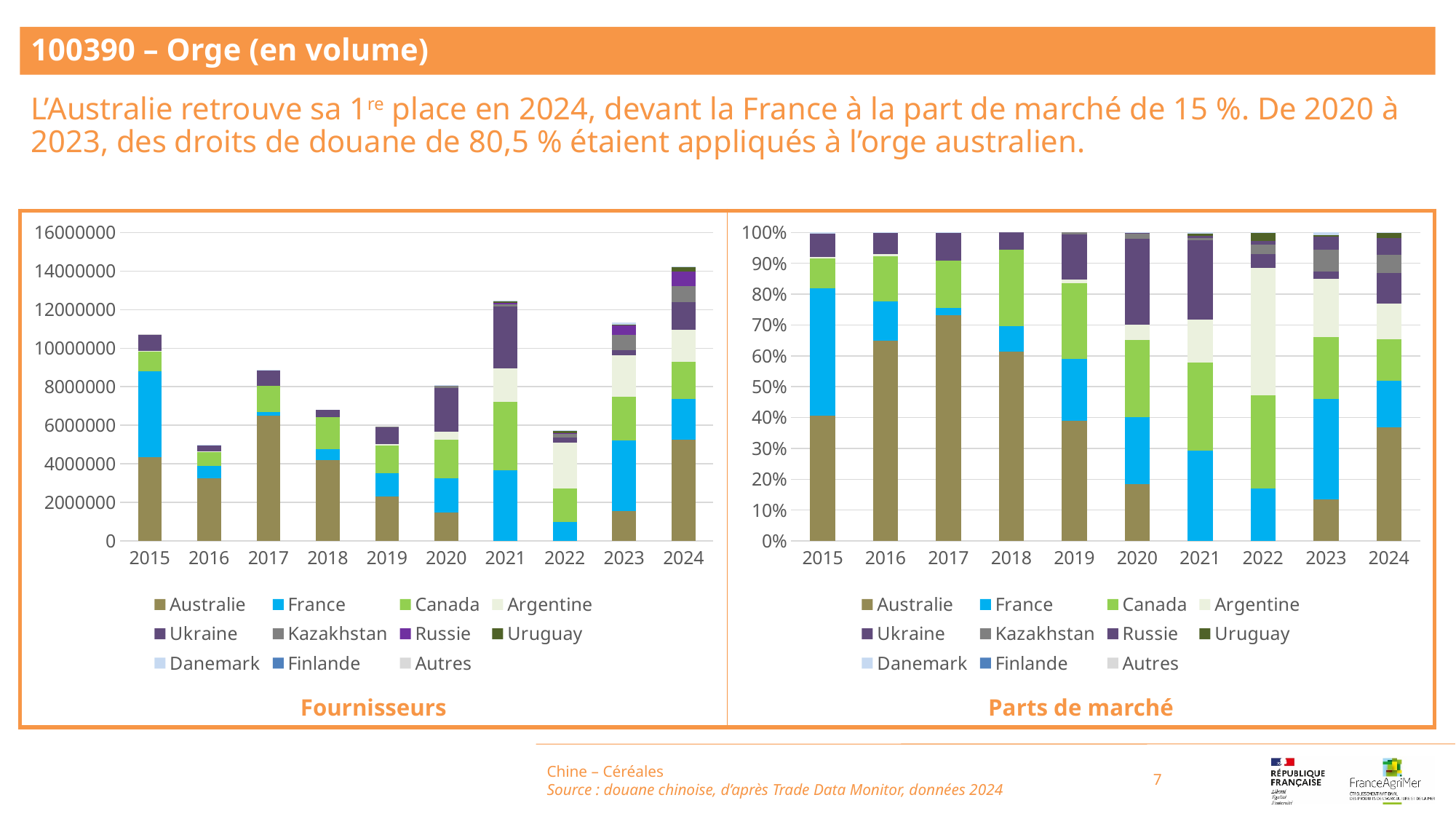
In the 'Parts de marché' chart, is the Australie share in 2015 greater or less than 50%? less How many series does the legend of the 'Fournisseurs' chart list? 11 What is the title printed under the right-hand chart? Parts de marché In the 'Parts de marché' chart, which is larger: the Australie share in 2017 or in 2019? 2017 In the 'Fournisseurs' chart, is the Australie value for 2017 greater or less than 6000000? greater Which series is shown in light blue (cyan) in the legend of the 'Fournisseurs' chart? France In the 'Fournisseurs' chart, which year has the highest total stacked bar? 2024 In the 'Parts de marché' chart, does the Australie share rise or fall from 2017 to 2022? fall In the 'Fournisseurs' chart, is the total for 2016 greater or less than 6000000? less What kind of chart is the 'Fournisseurs' chart on the left? stacked bar chart How many years are shown on the x axis of the 'Parts de marché' chart? 10